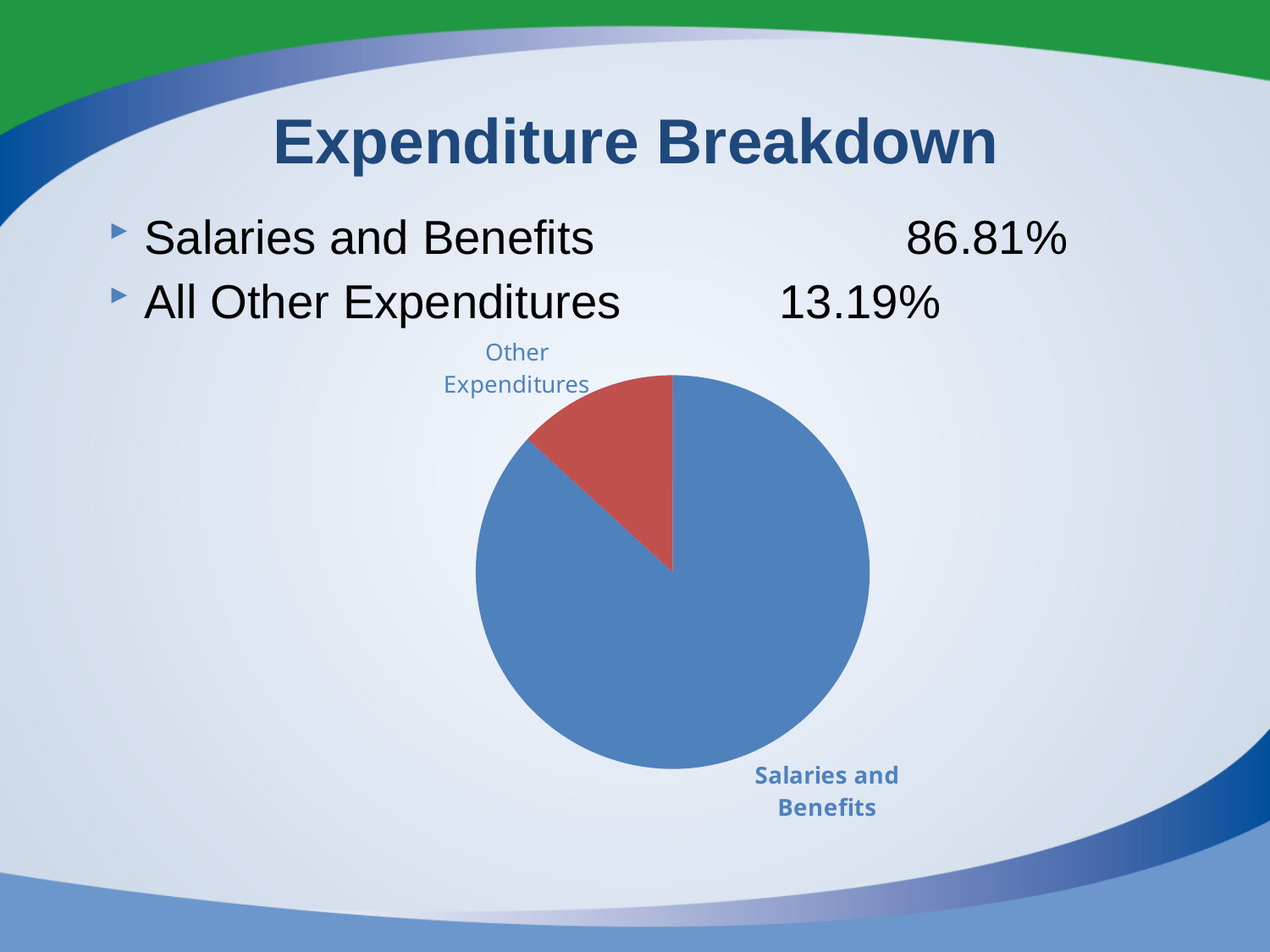
What share of expenditures goes to All Other Expenditures? 13.19% What kind of chart is shown on the slide? pie chart What share of expenditures goes to Salaries and Benefits? 86.81% What is the title of the slide containing the pie chart? Expenditure Breakdown Is the share for Salaries and Benefits greater or less than 50%? greater Which slice of the pie chart is the largest? Salaries and Benefits Is the share for Other Expenditures greater or less than 25%? less Which is larger, the Salaries and Benefits slice or the Other Expenditures slice? Salaries and Benefits How many slices does the pie chart have? 2 Which slice of the pie chart is the smallest? Other Expenditures What is the difference in percentage points between Salaries and Benefits and All Other Expenditures? 73.62 What colour is the Other Expenditures slice of the pie chart? red